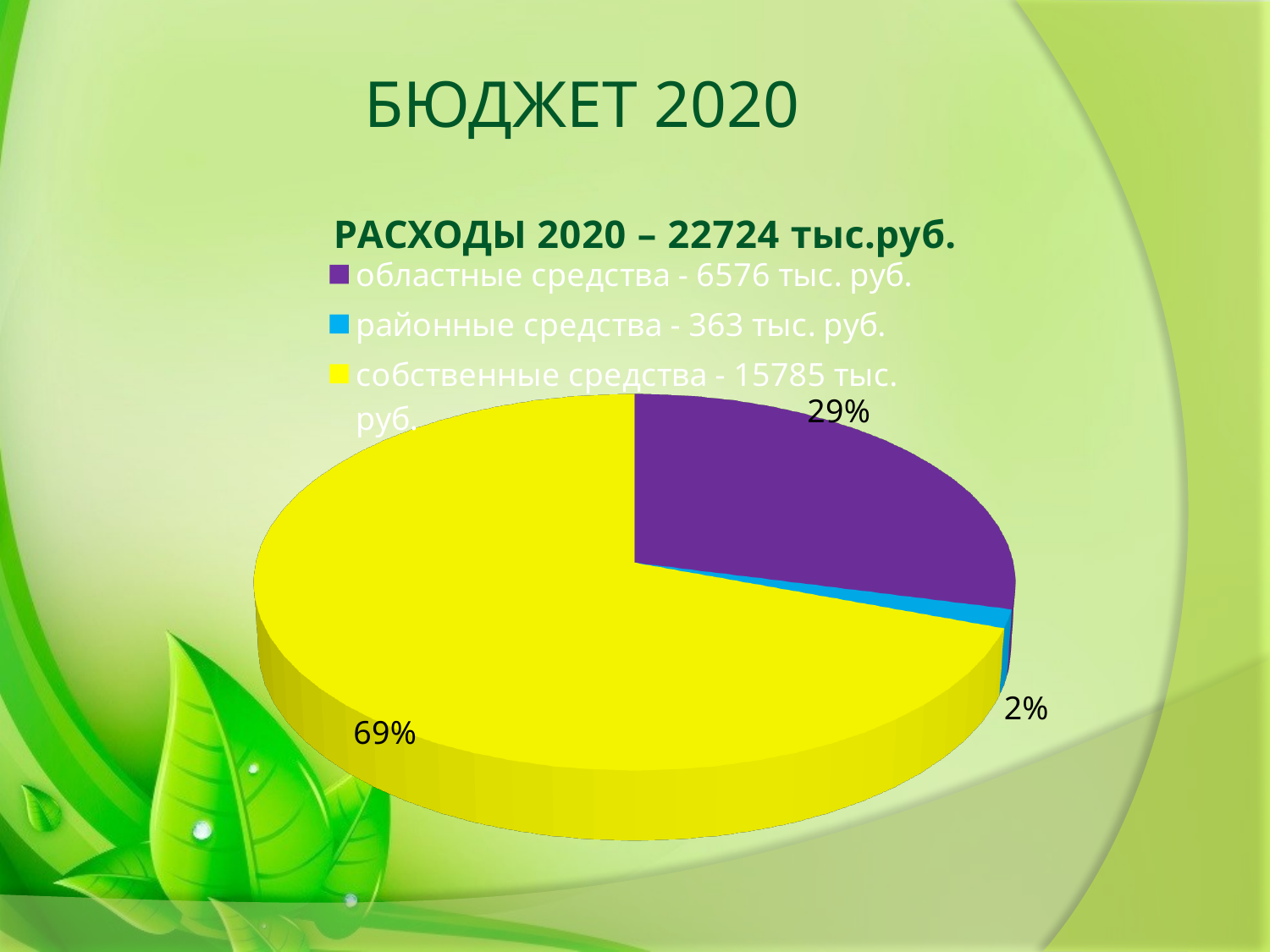
What share of the pie does 'районные средства' take? 2% Which category has the largest slice of the pie? собственные средства What colour is the 'собственные средства' slice in the pie chart? yellow How many slices does the pie chart have? 3 What share of the pie does 'областные средства' take? 29% What is the title of the pie chart? РАСХОДЫ 2020 – 22724 тыс.руб. What share of the pie does 'собственные средства' take? 69% What kind of chart is shown on the slide? pie chart What is the difference in percentage points between the 'собственные средства' slice and the 'областные средства' slice? 40 Which slice is larger: 'областные средства' or 'районные средства'? областные средства How many entries does the legend of the pie chart list? 3 Which category has the smallest slice of the pie? районные средства